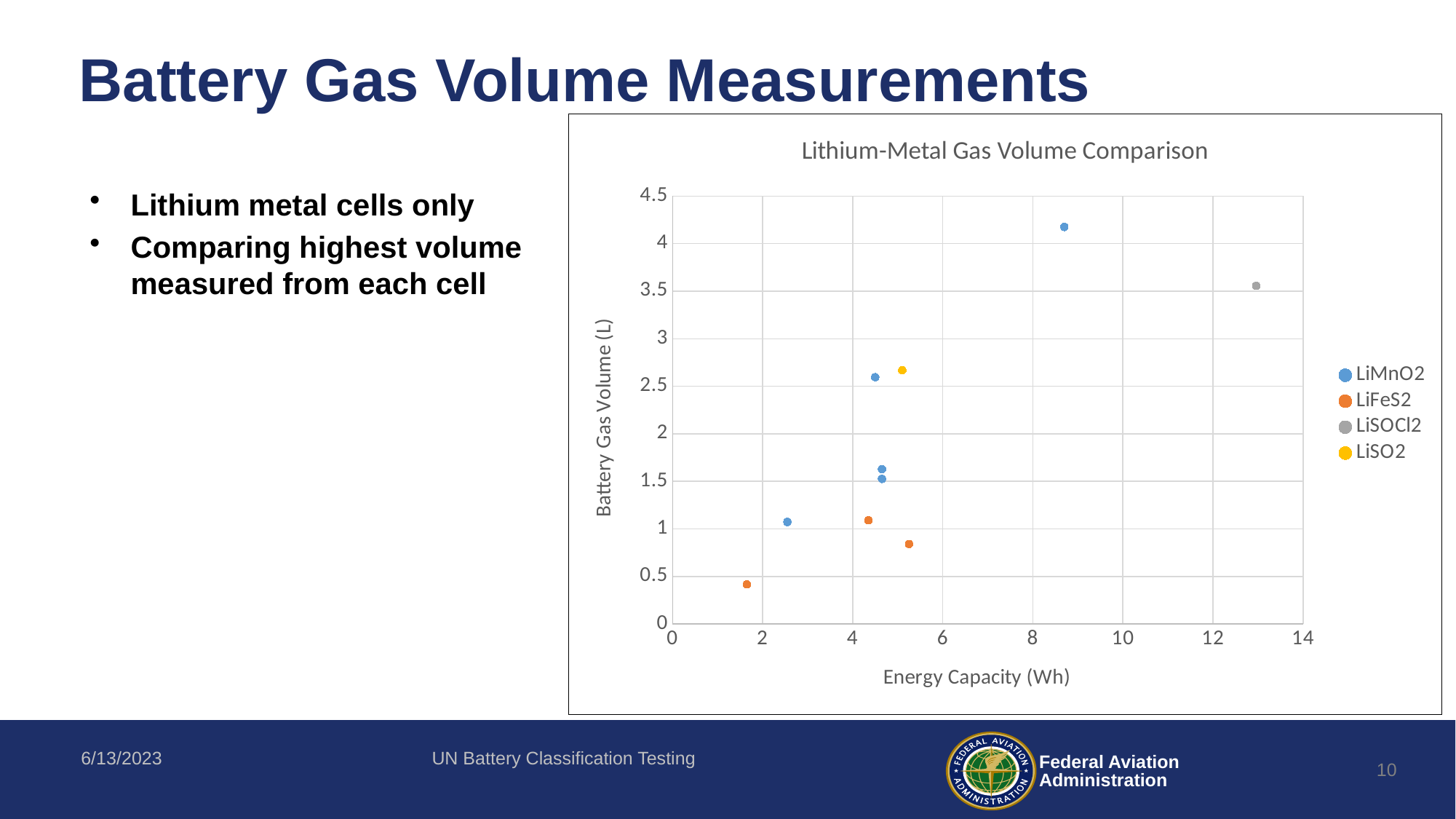
What is the title of the chart? Lithium-Metal Gas Volume Comparison How many LiFeS2 points are plotted on the chart? 3 How many LiMnO2 points are plotted on the chart? 5 Which series has the point with the highest energy capacity? LiSOCl2 How many data points are plotted on the chart in total? 10 What kind of chart is shown on the slide? scatter chart Is the battery gas volume of the LiSOCl2 point greater or less than 3 L? greater Is the energy capacity of the LiSOCl2 point greater or less than 12 Wh? greater Which series has the point with the lowest battery gas volume? LiFeS2 Which series has the point with the highest battery gas volume? LiMnO2 How many series does the chart legend list? 4 What is the label of the x axis? Energy Capacity (Wh)